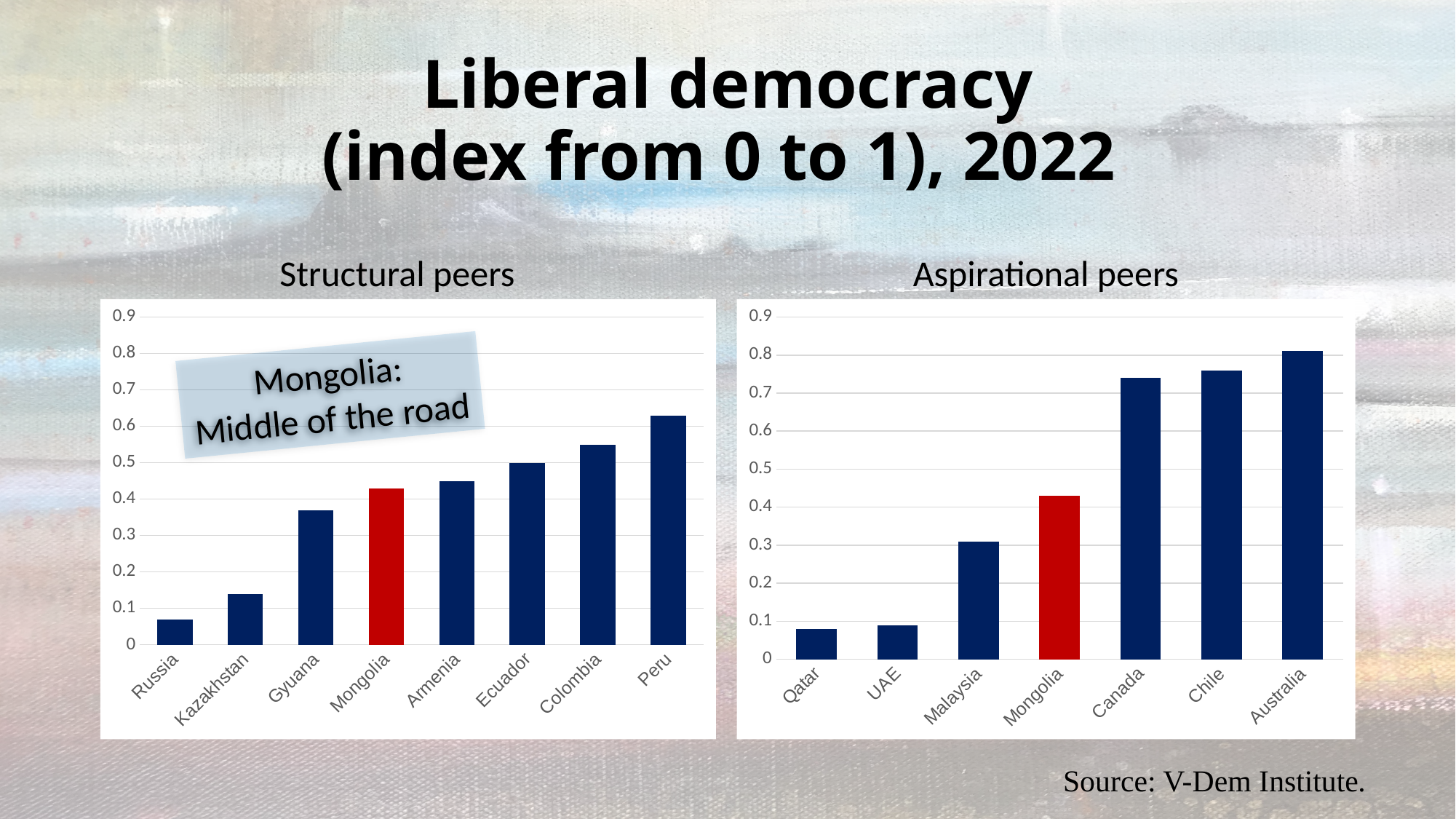
In the Aspirational peers chart, which has the larger value, Malaysia or Mongolia? Mongolia In the Structural peers chart, is the value for Mongolia greater or less than 0.5? less Which country's bar is highlighted in red in both charts? Mongolia In the Aspirational peers chart, which country has the highest liberal democracy index? Australia In the Structural peers chart, which country has the lowest liberal democracy index? Russia In the Aspirational peers chart, is the value for Canada greater or less than 0.7? greater In the Structural peers chart, which country has the highest liberal democracy index? Peru How many countries are shown in the Aspirational peers chart? 7 What kind of chart is the Aspirational peers chart? Bar chart In the Structural peers chart, is the value for Peru greater or less than 0.6? greater How many countries are shown in the Structural peers chart? 8 In the Structural peers chart, do the values rise or fall from left to right? Rise